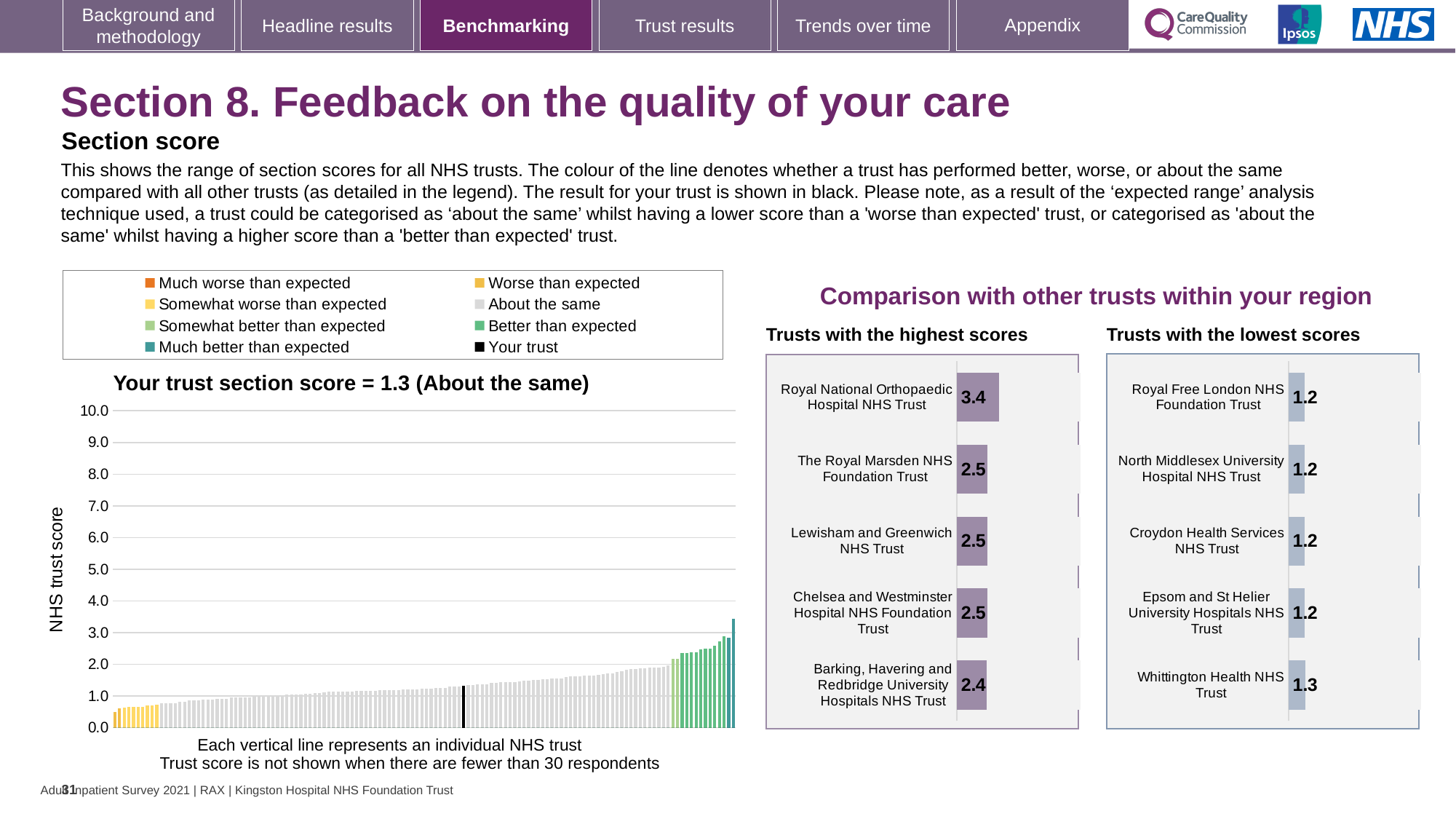
In the 'Trusts with the lowest scores' chart, what is the score for Croydon Health Services NHS Trust? 1.2 In the 'Trusts with the highest scores' chart, what is the score for Royal National Orthopaedic Hospital NHS Trust? 3.4 In the 'Your trust section score' chart, do the trust scores rise or fall from left to right? rise In the 'Your trust section score' chart, is the highest trust score greater or less than 4.0? less In the 'Trusts with the lowest scores' chart, what is the score for Whittington Health NHS Trust? 1.3 What kind of chart is the 'Your trust section score' chart? bar chart In the 'Trusts with the highest scores' chart, which trust has the highest score? Royal National Orthopaedic Hospital NHS Trust In the 'Your trust section score' chart, what is the highest value shown on the y axis? 10.0 In the 'Trusts with the highest scores' chart, how many trusts are shown? 5 In the 'Your trust section score' chart, how many entries does the legend list? 8 In the 'Your trust section score' chart, what is the section score for your trust? 1.3 In the 'Trusts with the highest scores' chart, what is the difference between the scores of Royal National Orthopaedic Hospital NHS Trust and Barking, Havering and Redbridge University Hospitals NHS Trust? 1.0